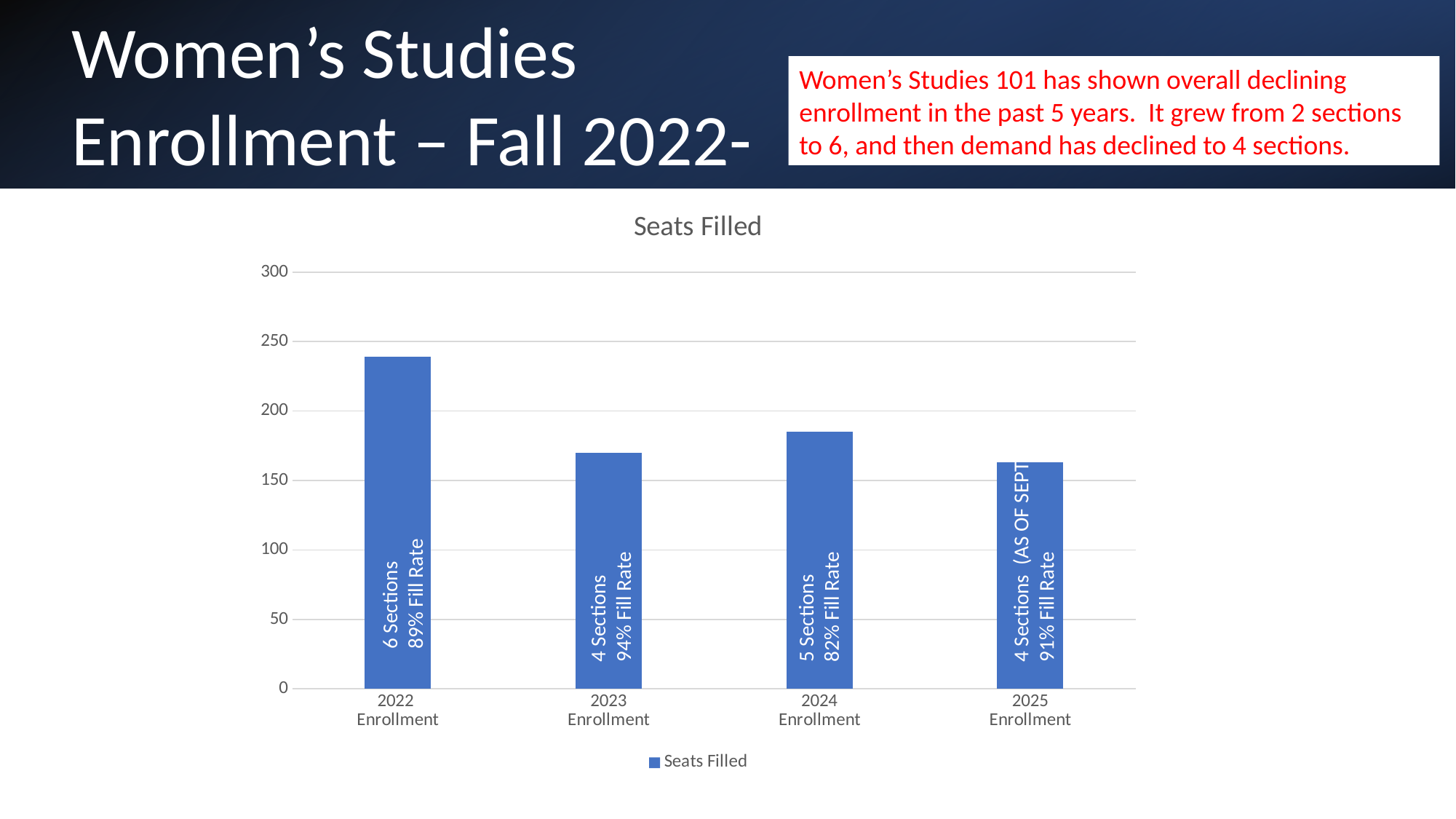
What is the title of the chart? Seats Filled What kind of chart is shown on the slide? bar chart What fill rate is shown on the bar for 2023 Enrollment? 94% Fill Rate Which year has the highest number of seats filled? 2022 Enrollment Is the value for 2022 Enrollment greater or less than 200? greater How many enrollment years are plotted on the chart? 4 Is the value for 2022 Enrollment greater or less than 250? less How many series does the chart legend list? 1 Is the value for 2025 Enrollment greater or less than 150? greater How many sections are shown on the bar for 2022 Enrollment? 6 Sections Which is larger, the seats filled for 2022 Enrollment or for 2024 Enrollment? 2022 Enrollment